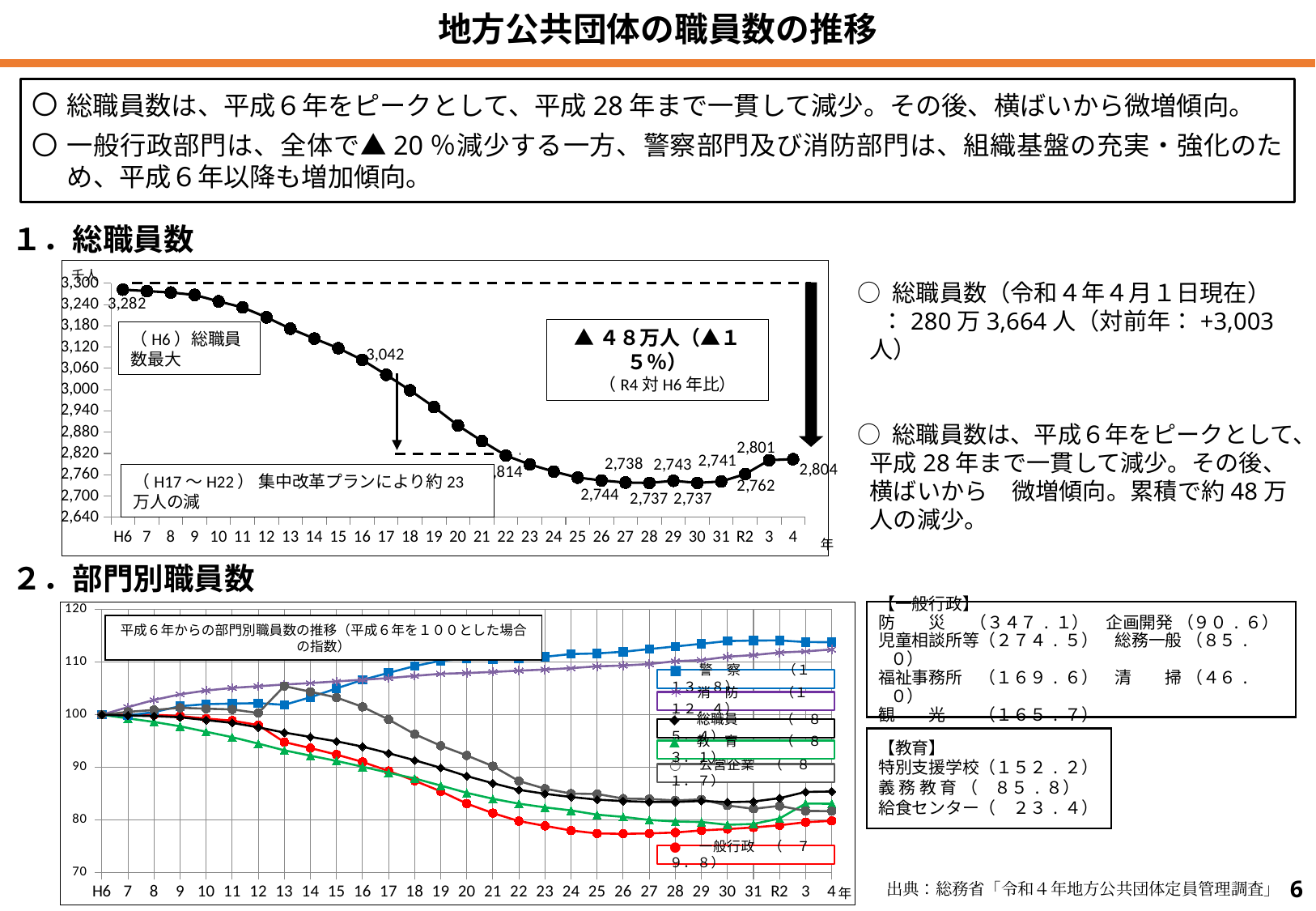
On the 総職員数 chart (top), what is the value for H6? 3,282 On the 総職員数 chart (top), is the value for H22 greater or less than 2,880? less On the 総職員数 chart (top), what is the difference between the H6 value and the R4 value? 478 On the 部門別職員数 chart (bottom), is the value for 一般行政 at H25 greater or less than 80? less What kind of chart is the 部門別職員数 chart (bottom)? line chart On the 総職員数 chart (top), do the values rise or fall from H6 to H28? fall On the 総職員数 chart (top), how many years are plotted on the x axis? 29 On the 部門別職員数 chart (bottom), which series has the highest value at R4? 警察 On the 総職員数 chart (top), which year has the highest value? H6 On the 総職員数 chart (top), what unit is shown at the top of the y axis? 千人 On the 総職員数 chart (top), what is the value for R4 (令和4年)? 2,804 On the 部門別職員数 chart (bottom), how many series does the legend list? 6